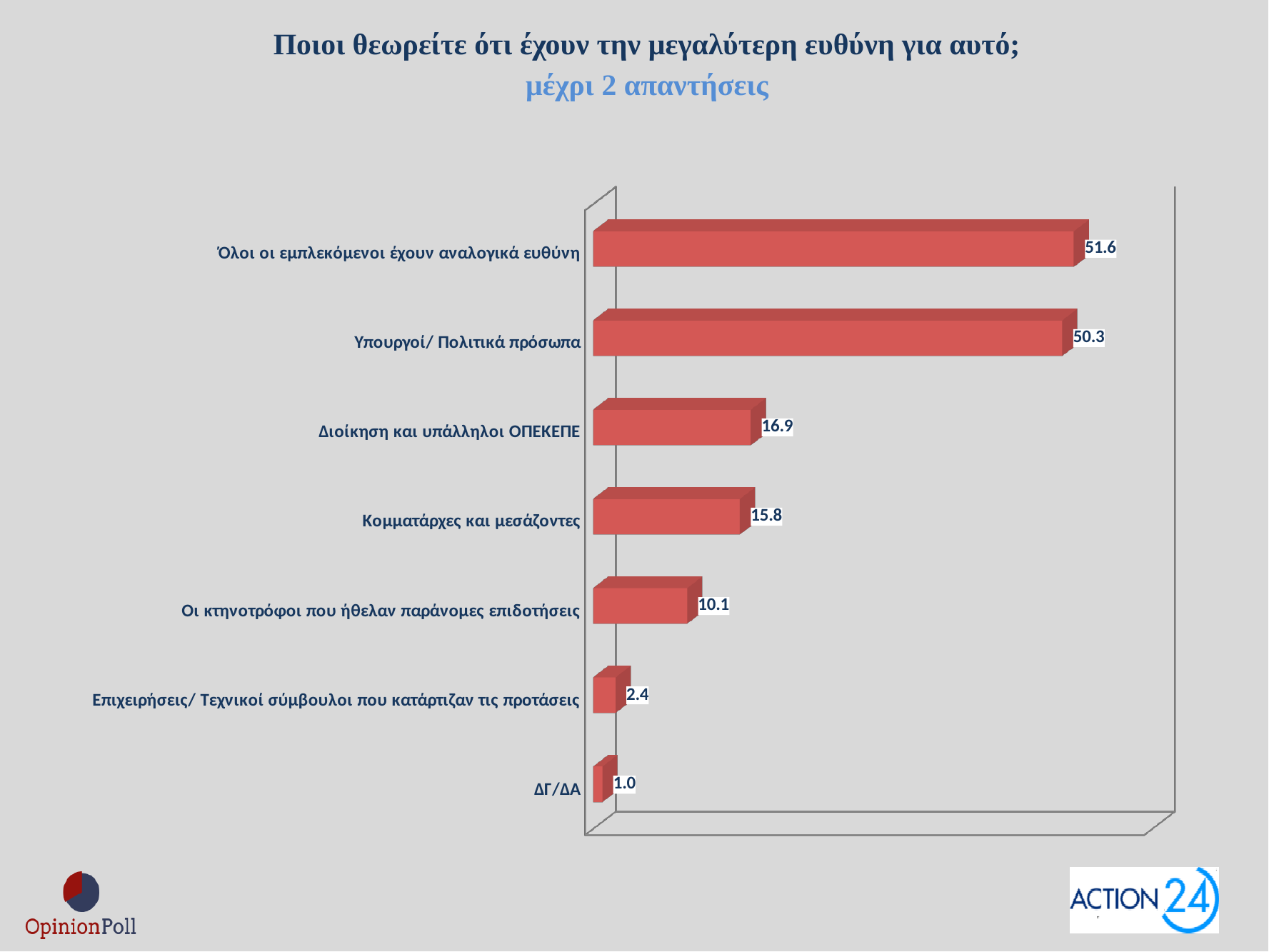
What is the value for 'Υπουργοί/ Πολιτικά πρόσωπα'? 50.3 What is the value for 'Διοίκηση και υπάλληλοι ΟΠΕΚΕΠΕ'? 16.9 What is the value for 'Οι κτηνοτρόφοι που ήθελαν παράνομες επιδοτήσεις'? 10.1 How many categories are shown in the chart? 7 What is the difference between the values for 'Διοίκηση και υπάλληλοι ΟΠΕΚΕΠΕ' and 'Κομματάρχες και μεσάζοντες'? 1.1 Which category has the lowest value? ΔΓ/ΔΑ What is the difference between the values for 'Όλοι οι εμπλεκόμενοι έχουν αναλογικά ευθύνη' and 'Υπουργοί/ Πολιτικά πρόσωπα'? 1.3 What is the value for 'Όλοι οι εμπλεκόμενοι έχουν αναλογικά ευθύνη'? 51.6 Which category has the highest value? Όλοι οι εμπλεκόμενοι έχουν αναλογικά ευθύνη Which is larger: the value for 'Κομματάρχες και μεσάζοντες' or the value for 'Οι κτηνοτρόφοι που ήθελαν παράνομες επιδοτήσεις'? Κομματάρχες και μεσάζοντες What kind of chart is shown on the slide? Bar chart What is the value for 'ΔΓ/ΔΑ'? 1.0